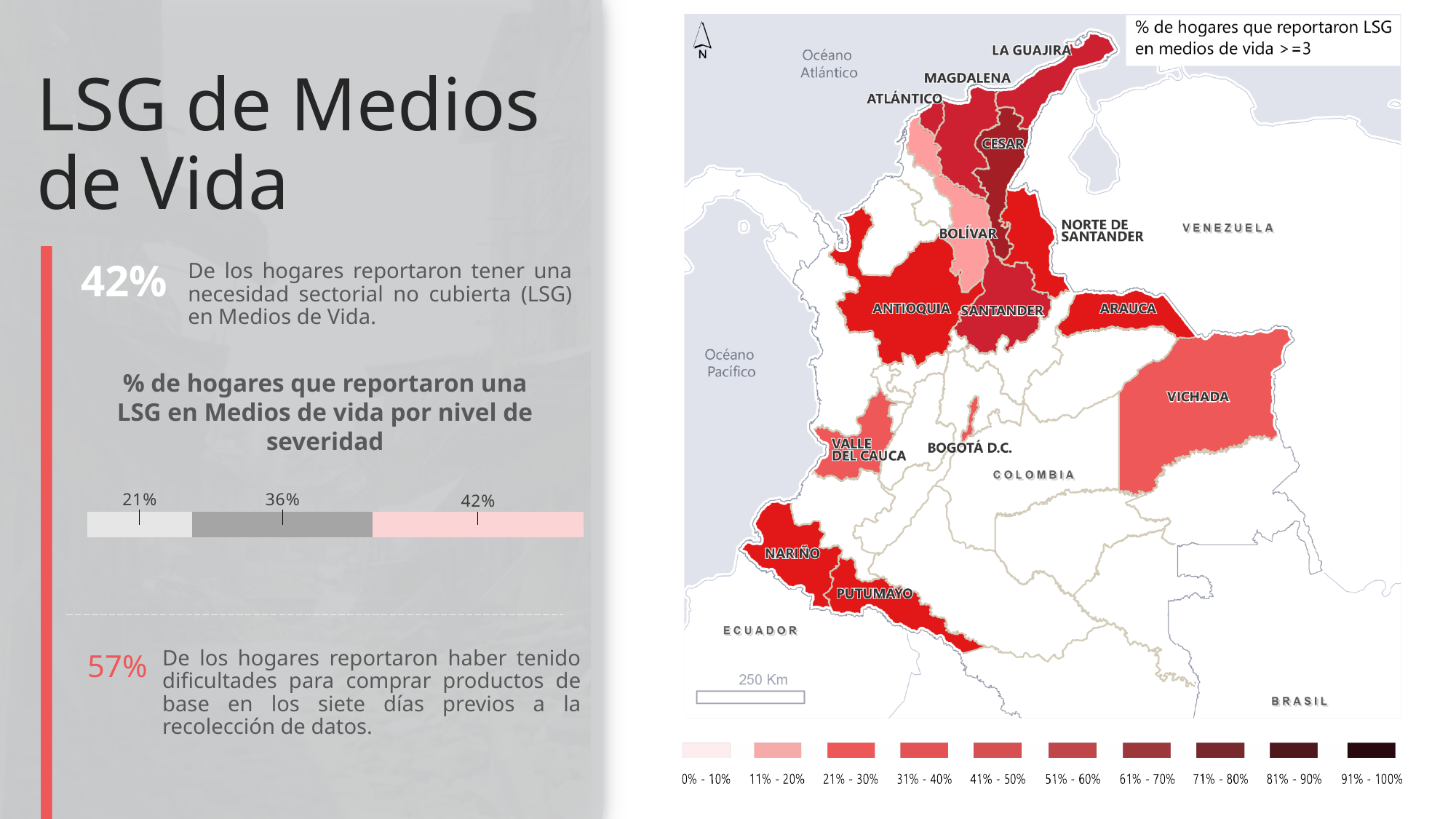
In the bar chart on the left, what is the difference between the largest value (42%) and the smallest value (21%)? 21% In the bar chart on the left, which is larger: the value of the first segment or the value of the last segment? The last segment (42%) In the bar chart on the left, what is the lowest value shown? 21% On the map of Colombia, which legend range does Bolívar fall into? 11% - 20% In the bar chart '% de hogares que reportaron una LSG en Medios de vida por nivel de severidad', how many segments are labelled with values? 3 In the bar chart on the left, do the segment values increase or decrease from left to right? Increase In the bar chart on the left, what is the value of the middle (dark grey) segment? 36% In the bar chart on the left, what is the highest value shown? 42% What kind of chart is shown under the title '% de hogares que reportaron una LSG en Medios de vida por nivel de severidad'? Bar chart On the map of Colombia, which department is shaded the darkest? Cesar What is the title of the bar chart on the left side of the slide? % de hogares que reportaron una LSG en Medios de vida por nivel de severidad On the map of Colombia, how many colour ranges does the legend list? 10